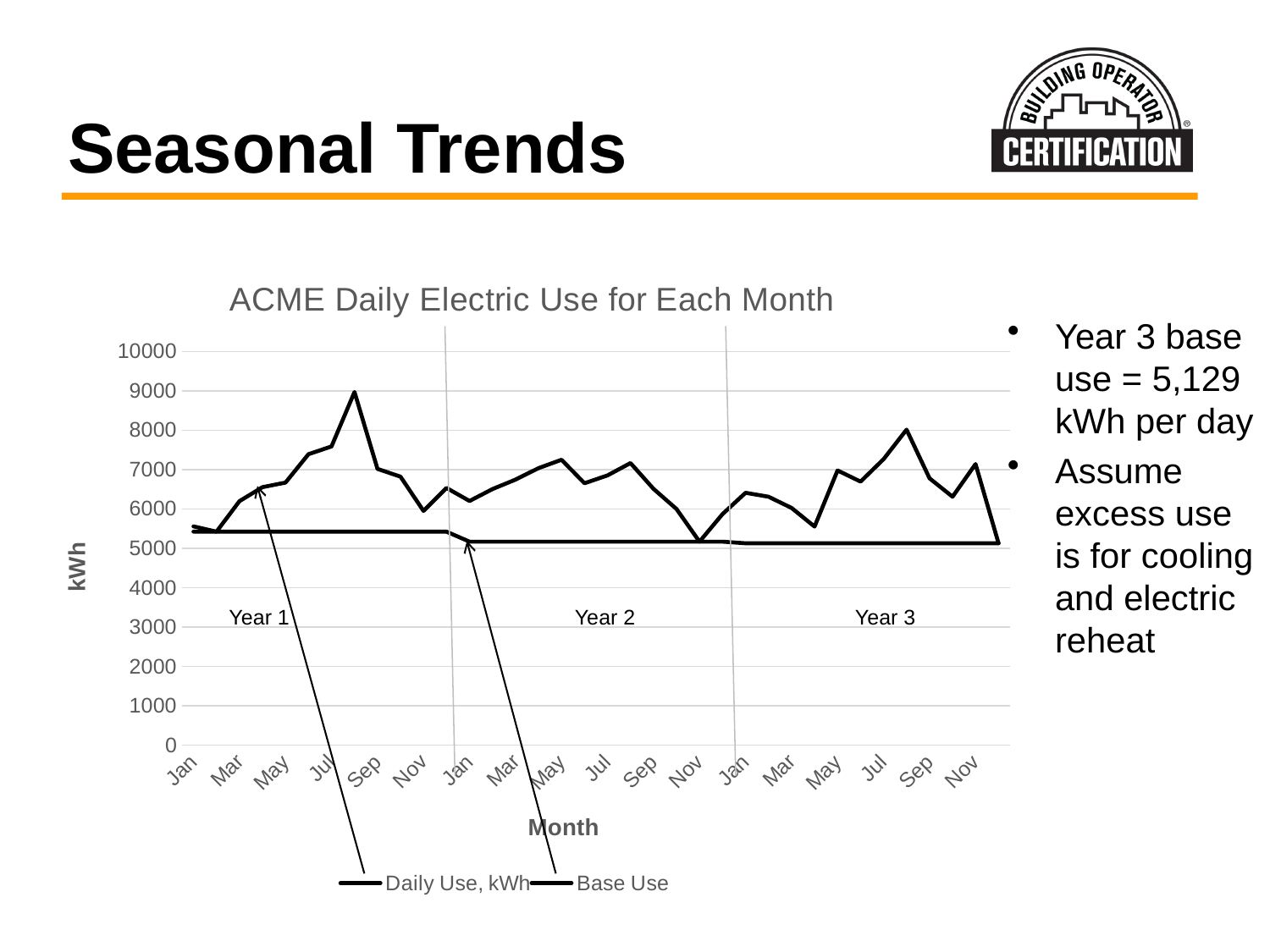
How many years of monthly data does the chart cover? 3 Is the Daily Use value for Sep of Year 1 greater or less than 8000? less What type of chart is shown on the slide? line chart In which month of Year 1 does the Daily Use line reach its peak? Aug In which year does the Daily Use line reach its highest peak? Year 1 What is the title of the chart? ACME Daily Electric Use for Each Month How many series does the chart legend list? 2 Does the Daily Use line rise or fall from Jan to Sep of Year 1? rise Which is larger: the Daily Use peak in Sep of Year 1 or the Daily Use peak in Jul of Year 3? Jul of Year 3 What are the two series named in the chart legend? Daily Use, kWh and Base Use Is the Daily Use value for Nov of Year 2 greater or less than 6000? less Is the Daily Use value for Jul of Year 3 greater or less than 7000? greater